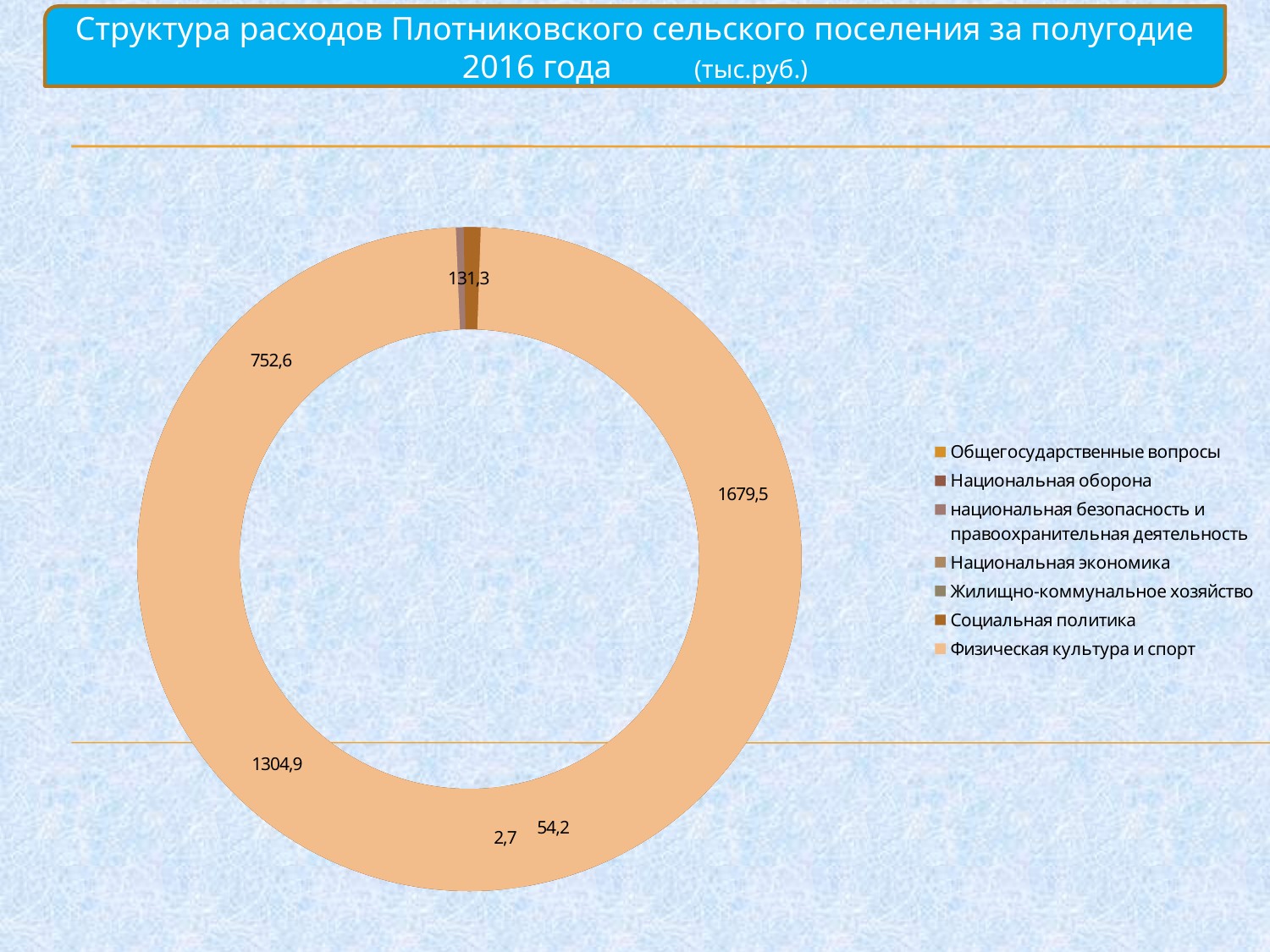
How many entries does the chart legend list? 7 What is the smallest value labelled on the chart? 2,7 Which labelled value is larger, 752,6 or 131,3? 752,6 What is the last entry in the chart legend? Физическая культура и спорт What kind of chart is shown on the slide? doughnut chart In what units are the chart values given, according to the slide title? тыс.руб. What is the largest value labelled on the chart? 1679,5 What is the difference between the two largest labelled values, 1679,5 and 1304,9? 374,6